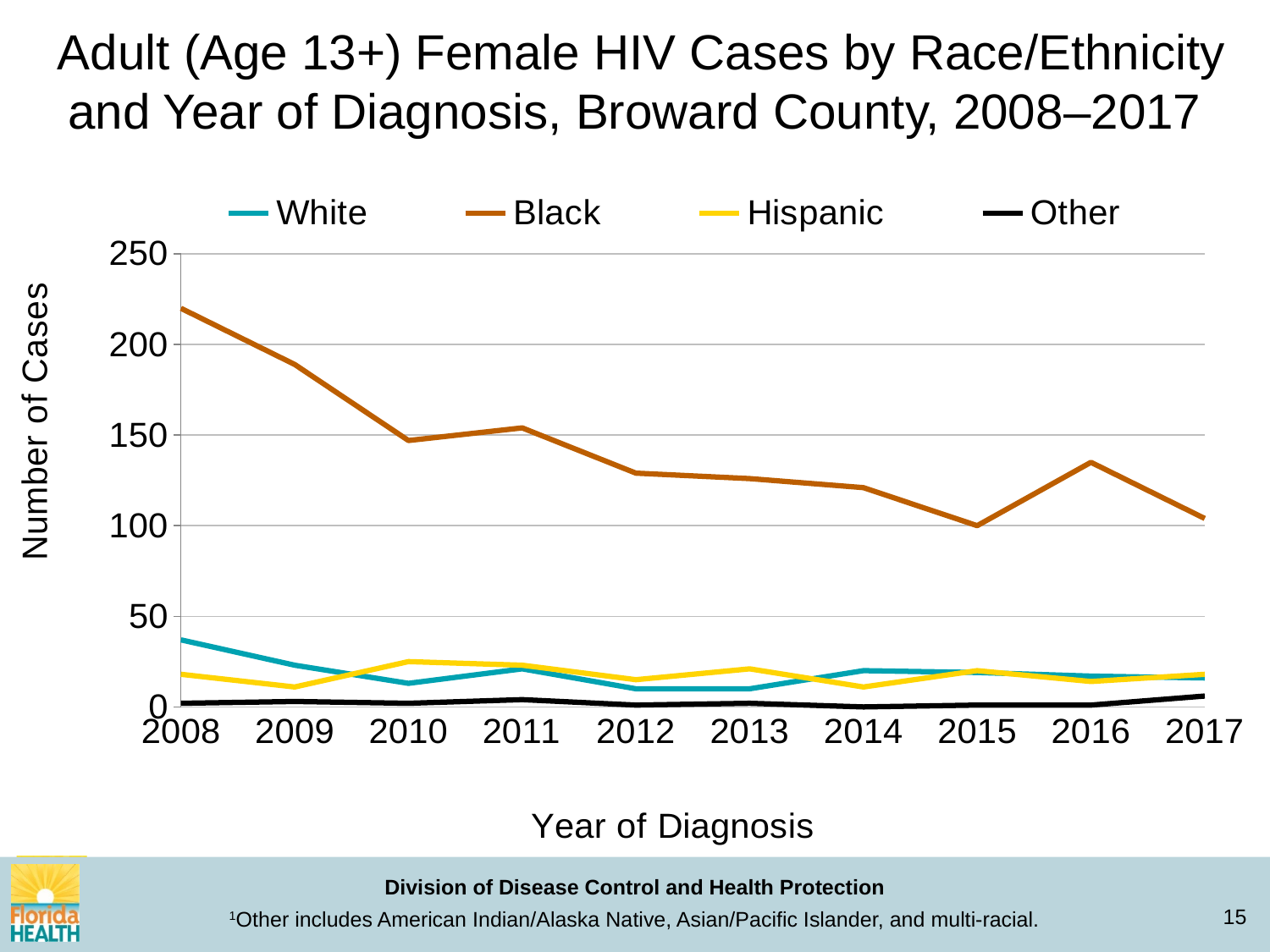
Is the value for Black in 2012 greater or less than 150? less In which year is the Black series at its highest? 2008 What kind of chart is shown on the slide? line chart In which year is the Black series at its lowest? 2015 Is the value for White in 2008 greater or less than 50? less Does the Black series generally rise or fall from 2008 to 2017? fall Which series has the larger value in 2008, Black or White? Black How many series does the legend list? 4 How many years are plotted along the x axis? 10 Is the value for Black in 2016 greater or less than 150? less What is the label of the y axis? Number of Cases